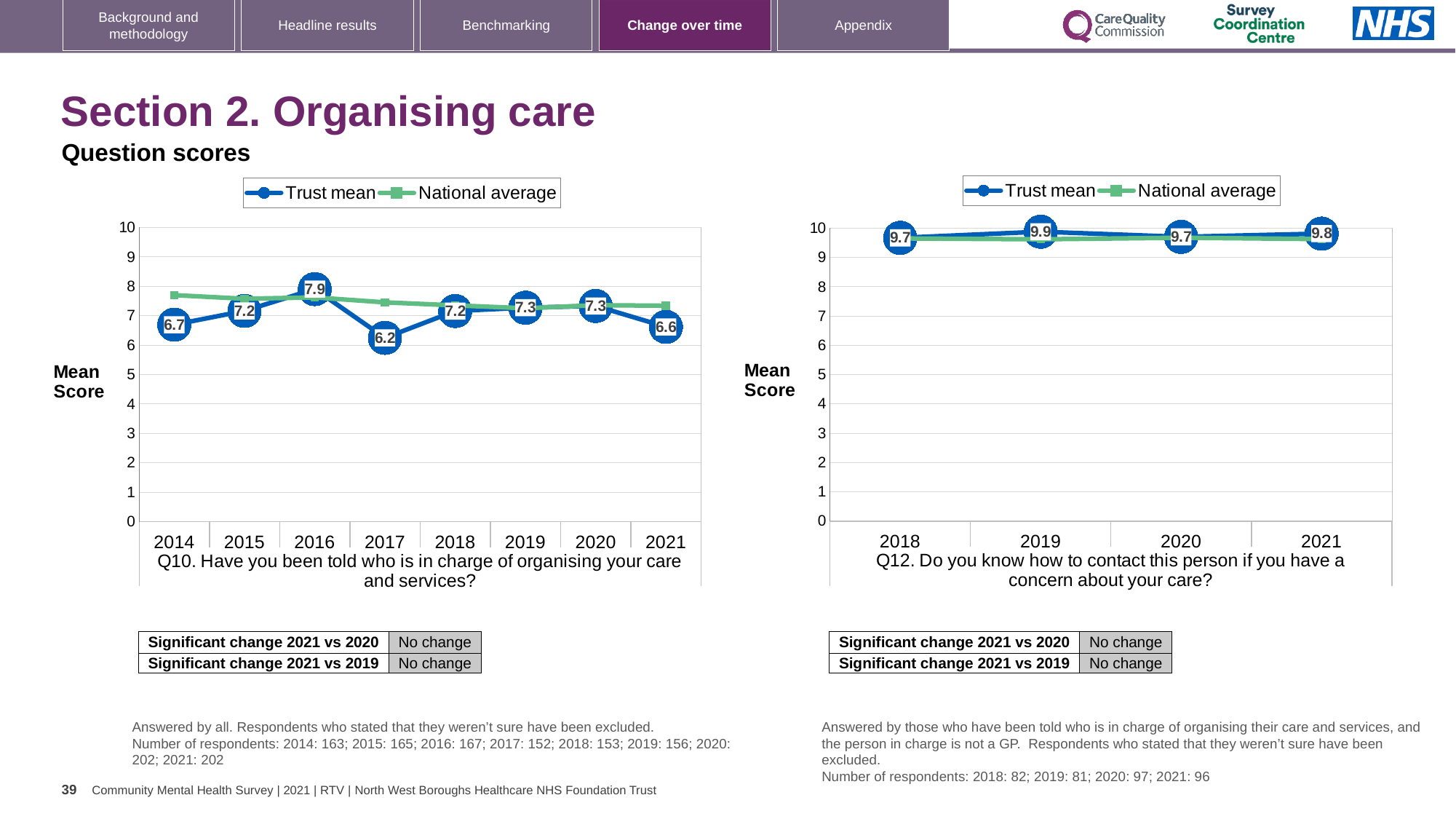
In the Q10 chart on the left, which year has the highest Trust mean score? 2016 In the Q10 chart on the left, is the National average for 2014 greater or less than 7? greater In the Q10 chart on the left, what is the difference between the Trust mean scores for 2016 and 2017? 1.7 In the Q10 chart on the left, which year has the lowest Trust mean score? 2017 In the Q12 chart on the right, what is the Trust mean score for 2021? 9.8 In the Q12 chart on the right, how many series does the legend list? 2 In the Q10 chart on the left, what is the Trust mean score for 2017? 6.2 In the Q10 chart on the left, is the Trust mean score for 2021 higher or lower than for 2020? Lower In the Q10 chart on the left, how many years are shown on the x axis? 8 In the Q10 chart on the left, what is the Trust mean score for 2021? 6.6 In the Q12 chart on the right, what is the Trust mean score for 2019? 9.9 What type of chart is the Q12 chart on the right? Line chart